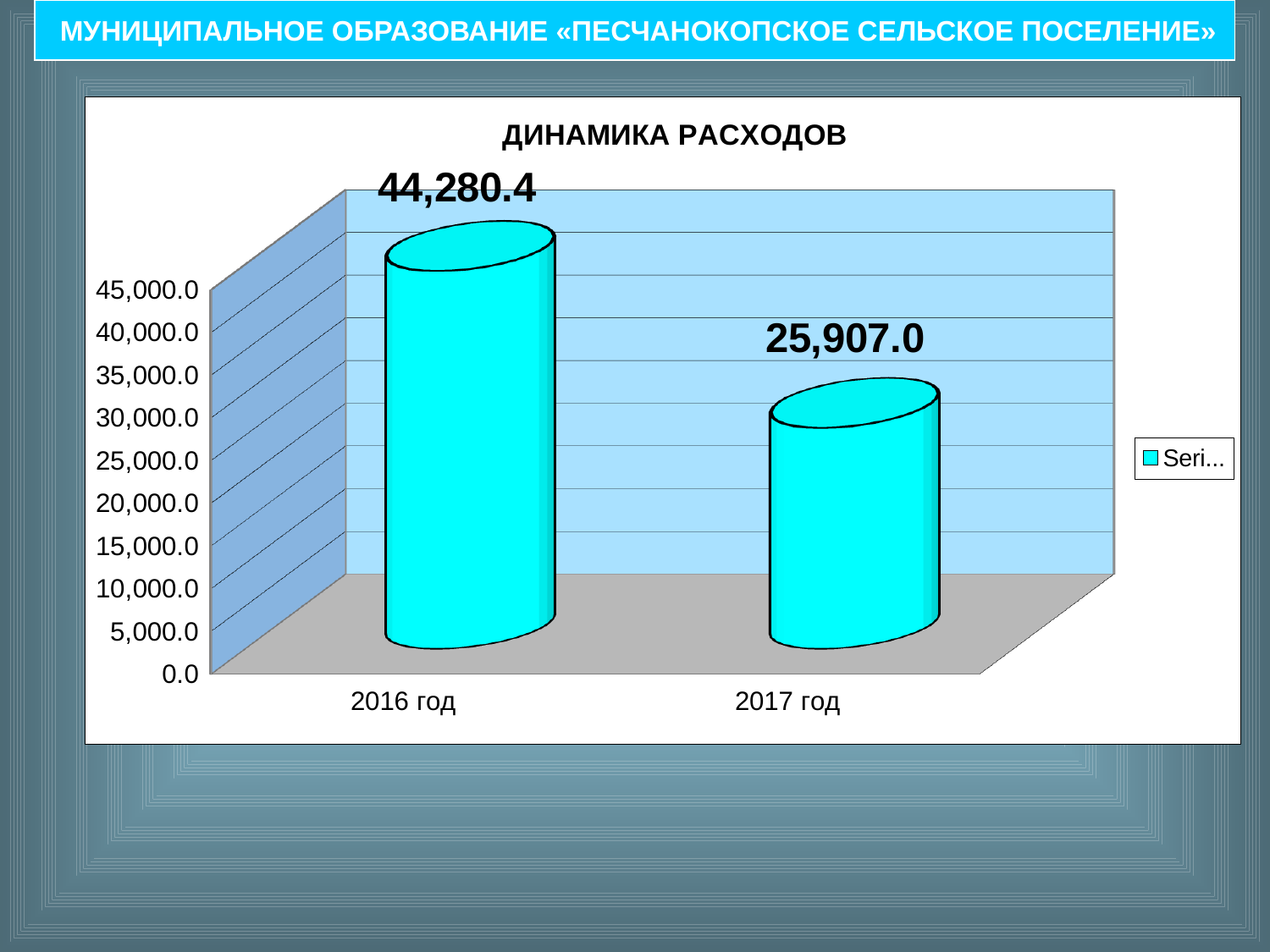
Which year has the highest value? 2016 год What kind of chart is this? bar chart What is the value for 2017 год? 25,907.0 What is the difference between the values for 2016 год and 2017 год? 18,373.4 Which year has the lowest value? 2017 год How many categories are shown on the x axis? 2 Is the value for 2016 год greater or less than 40,000.0? greater What is the title of the chart? ДИНАМИКА РАСХОДОВ Do the values rise or fall from 2016 год to 2017 год? fall Is the value for 2017 год greater or less than 30,000.0? less What is the value for 2016 год? 44,280.4 Which is larger, the value for 2016 год or for 2017 год? 2016 год